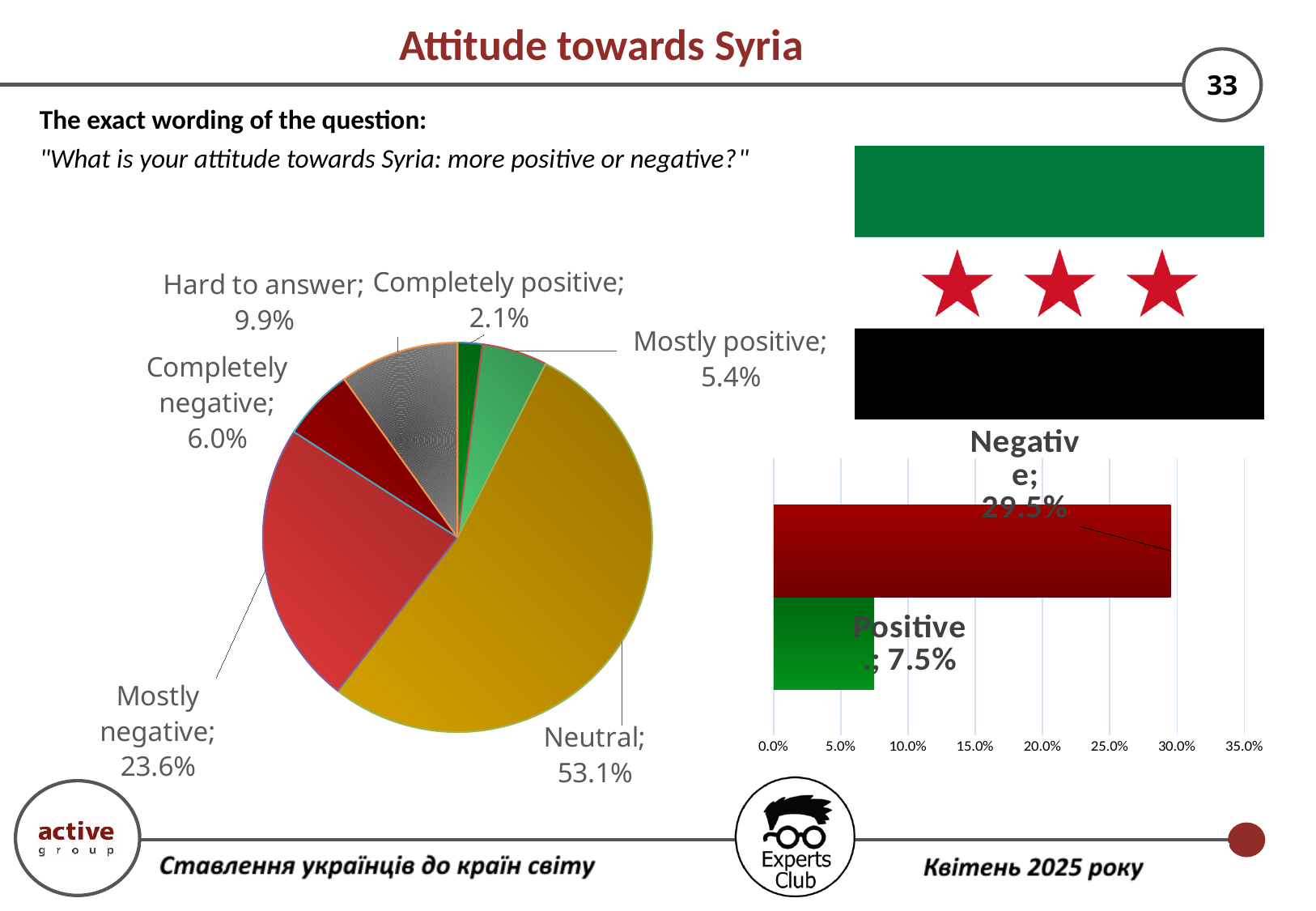
What type of chart is shown on the right side of the slide? Bar chart In the pie chart on the left, what share of respondents answered Neutral? 53.1% In the pie chart on the left, what is the value for Mostly negative? 23.6% In the bar chart on the right, what is the value for Positive? 7.5% In the pie chart on the left, which category has the smallest share? Completely positive In the pie chart on the left, which is larger: Completely negative or Mostly positive? Completely negative In the pie chart on the left, how many categories are shown? 6 In the pie chart on the left, which category has the largest share? Neutral In the pie chart on the left, what is the value for Hard to answer? 9.9% In the bar chart on the right, what is the value for Negative? 29.5% In the bar chart on the right, what is the difference between Negative and Positive? 22.0% In the pie chart on the left, what is the difference between Mostly positive and Completely positive? 3.3%